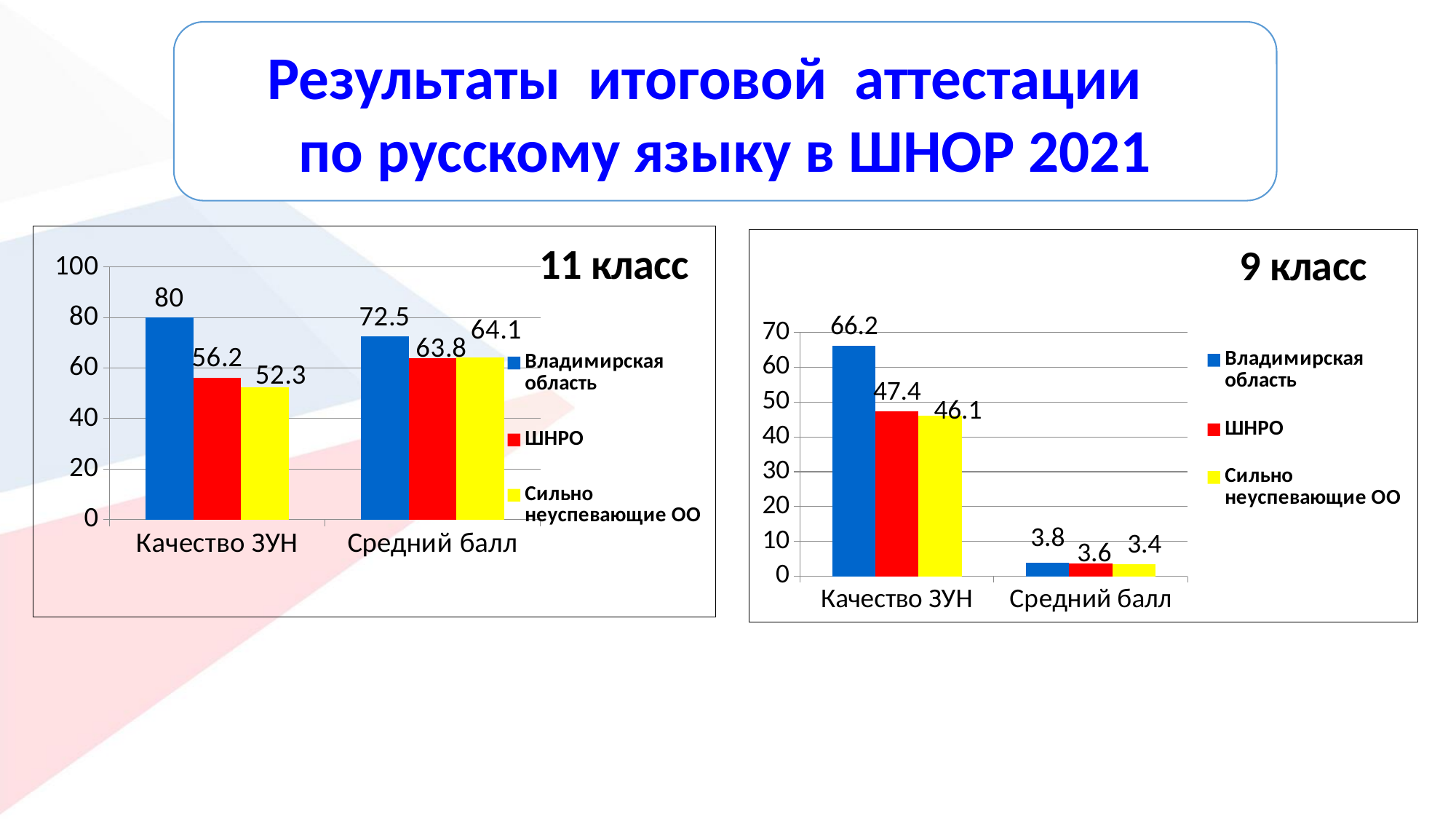
In the 9 класс chart, what is the difference between Владимирская область and ШНРО in Качество ЗУН? 18.8 How many series does the legend of the 9 класс chart list? 3 In the 9 класс chart, which is larger in Средний балл: ШНРО or Сильно неуспевающие ОО? ШНРО What kind of chart is the 11 класс chart? Bar chart In the 9 класс chart, what is the value for Сильно неуспевающие ОО in Качество ЗУН? 46.1 In the 11 класс chart, which series has the highest value in Средний балл? Владимирская область In the 11 класс chart, what colour represents ШНРО? Red In the 11 класс chart, what is the value for Владимирская область in Качество ЗУН? 80 In the 11 класс chart, what is the difference between Владимирская область and Сильно неуспевающие ОО in Качество ЗУН? 27.7 In the 11 класс chart, which series has the lowest value in Качество ЗУН? Сильно неуспевающие ОО In the 9 класс chart, what is the value for Владимирская область in Средний балл? 3.8 In the 11 класс chart, what is the value for ШНРО in Средний балл? 63.8